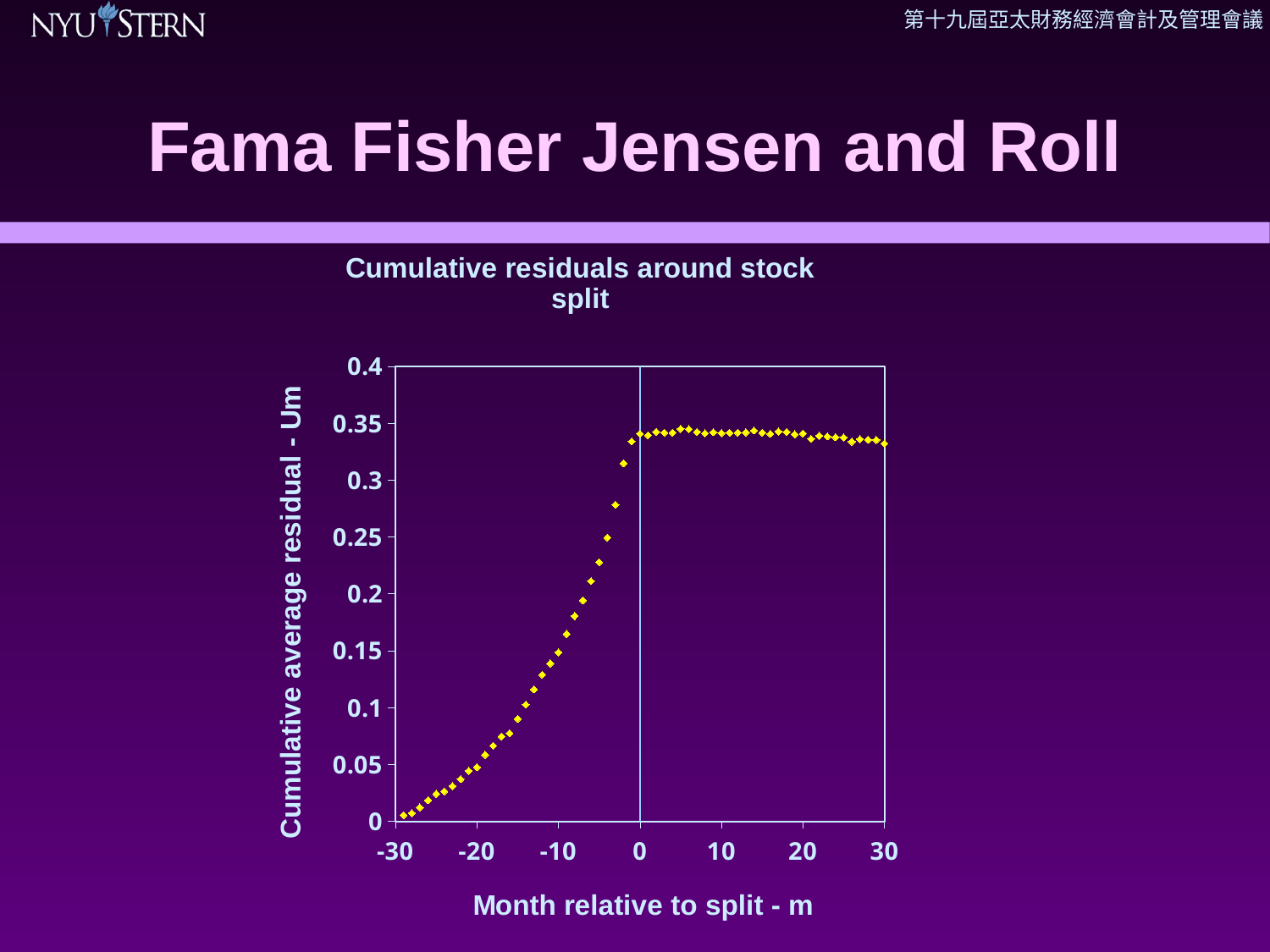
What is the title of the chart? Cumulative residuals around stock split Which is larger, the value at month -20 or the value at month 20? month 20 What type of chart is shown on the slide? scatter chart Is the value at month -20 greater or less than 0.1? less Is the value at month 30 greater or less than 0.3? greater Do the values rise sharply or stay roughly flat from month 0 to month 30? stay roughly flat Is the value at month -30 greater or less than 0.05? less Do the values rise or fall from month -30 to month 0? rise What is the label of the x axis? Month relative to split - m Which is larger, the value at month 0 or the value at month -10? month 0